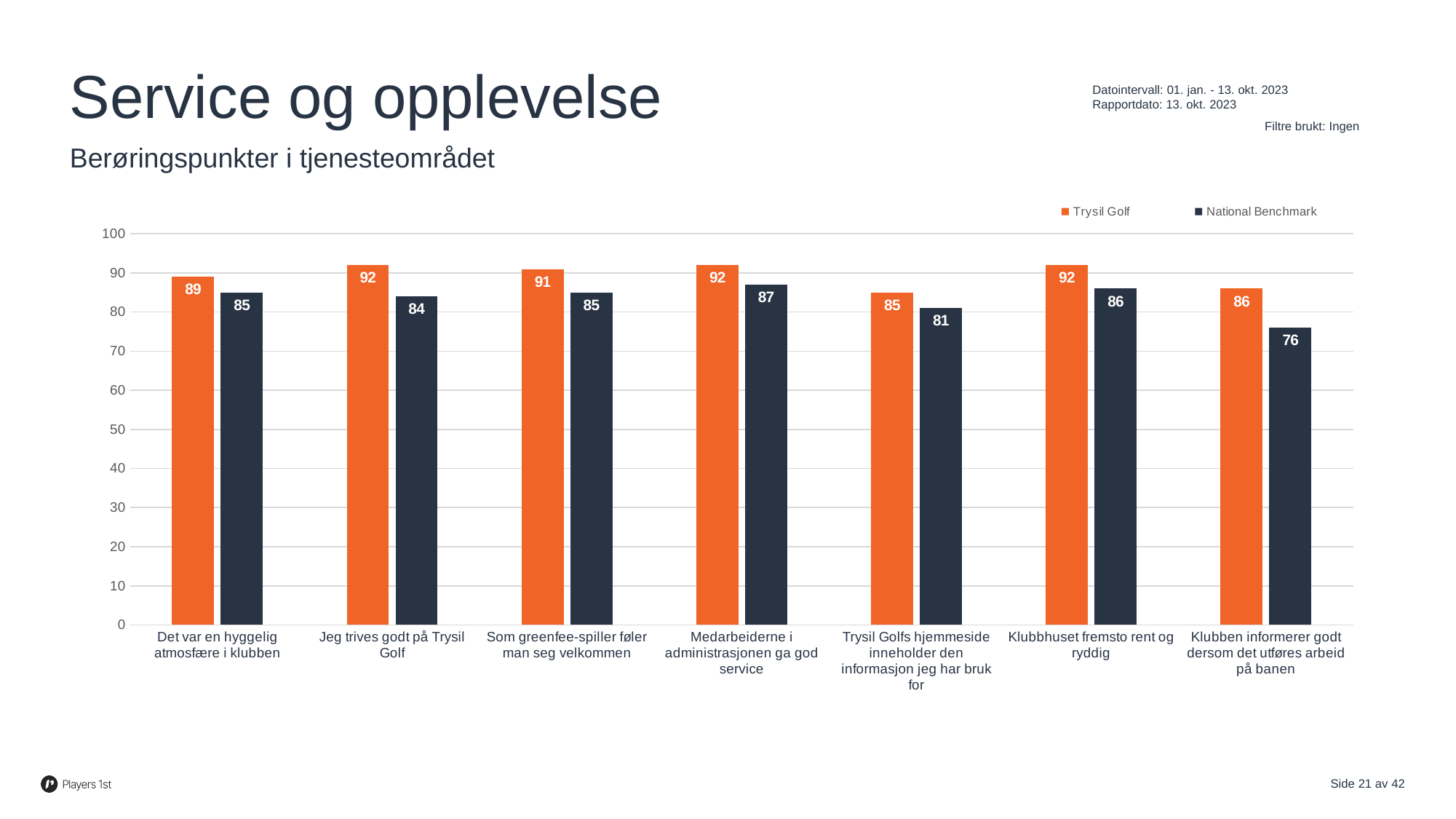
How many series does the legend list? 2 What is the National Benchmark value for "Medarbeiderne i administrasjonen ga god service"? 87 How many categories are shown on the x axis of the chart? 7 Which category has the lowest National Benchmark value? Klubben informerer godt dersom det utføres arbeid på banen What is the National Benchmark value for "Klubben informerer godt dersom det utføres arbeid på banen"? 76 What is the difference between the Trysil Golf and National Benchmark values for "Klubben informerer godt dersom det utføres arbeid på banen"? 10 Which category has the highest National Benchmark value? Medarbeiderne i administrasjonen ga god service What is the Trysil Golf value for "Det var en hyggelig atmosfære i klubben"? 89 For "Klubbhuset fremsto rent og ryddig", which is larger: the Trysil Golf value or the National Benchmark value? Trysil Golf Which category has the lowest Trysil Golf value? Trysil Golfs hjemmeside inneholder den informasjon jeg har bruk for What is the difference between the Trysil Golf and National Benchmark values for "Jeg trives godt på Trysil Golf"? 8 What kind of chart is shown on the slide? Bar chart